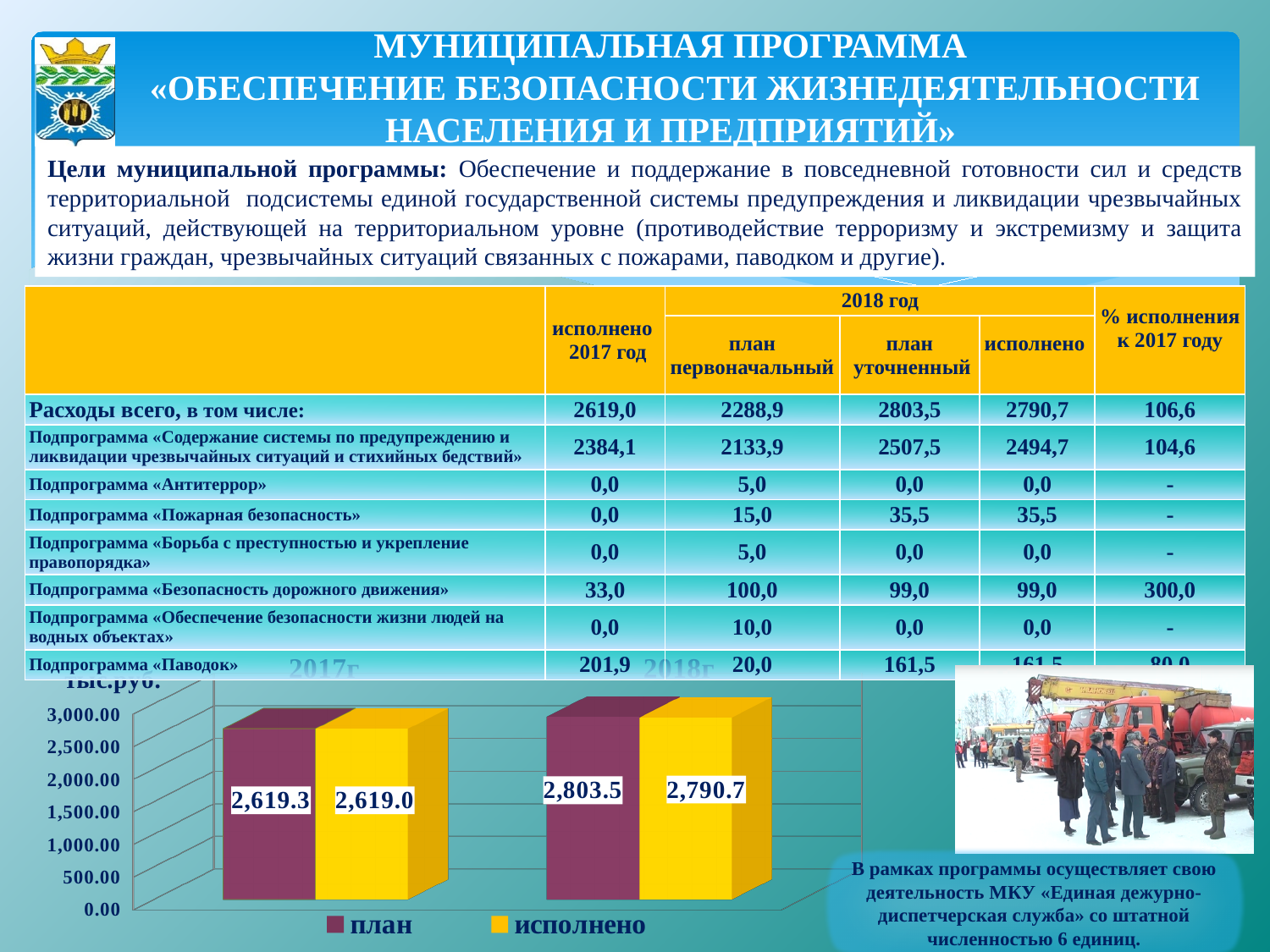
What are the two legend entries of the chart? план, исполнено What is the difference between the план and исполнено values for 2018 in the chart? 12.8 By how much does the план value for 2018 exceed the план value for 2017 in the chart? 184.2 Which bar in the chart has the highest value? план for 2018 (2,803.5) For 2018, which is larger in the chart: план or исполнено? план What is the value of the исполнено bar for 2018 in the chart? 2,790.7 What is the value of the план bar for 2018 in the chart? 2,803.5 What type of chart is shown at the bottom of the slide? bar chart Does the исполнено value rise or fall from 2017 to 2018 in the chart? rise How many series does the chart legend list? 2 What is the value of the исполнено bar for 2017 in the chart? 2,619.0 What is the value of the план bar for 2017 in the chart? 2,619.3